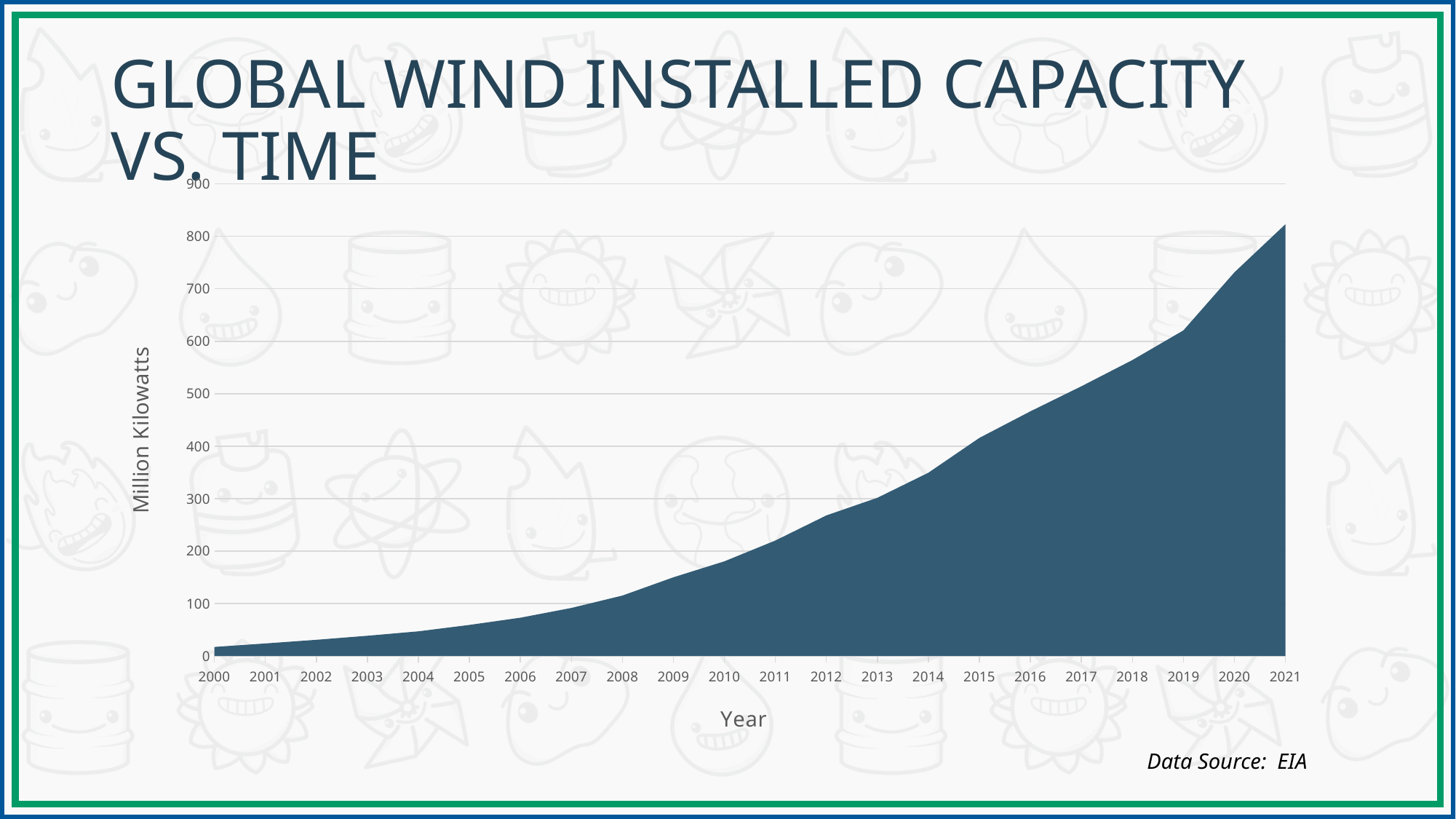
Is the value for 2021 greater or less than 800? greater What kind of chart is shown on the slide? Area chart Is the value for 2008 greater or less than 100? greater Is the value for 2016 greater or less than 500? less Do the values rise or fall from 2000 to 2021? Rise Which year has the lowest global wind installed capacity? 2000 Which year has the highest global wind installed capacity? 2021 How many years are plotted along the x axis of the chart? 22 What is the title of the chart? GLOBAL WIND INSTALLED CAPACITY VS. TIME What unit is shown on the vertical axis of the chart? Million Kilowatts Which year has the larger value, 2010 or 2018? 2018